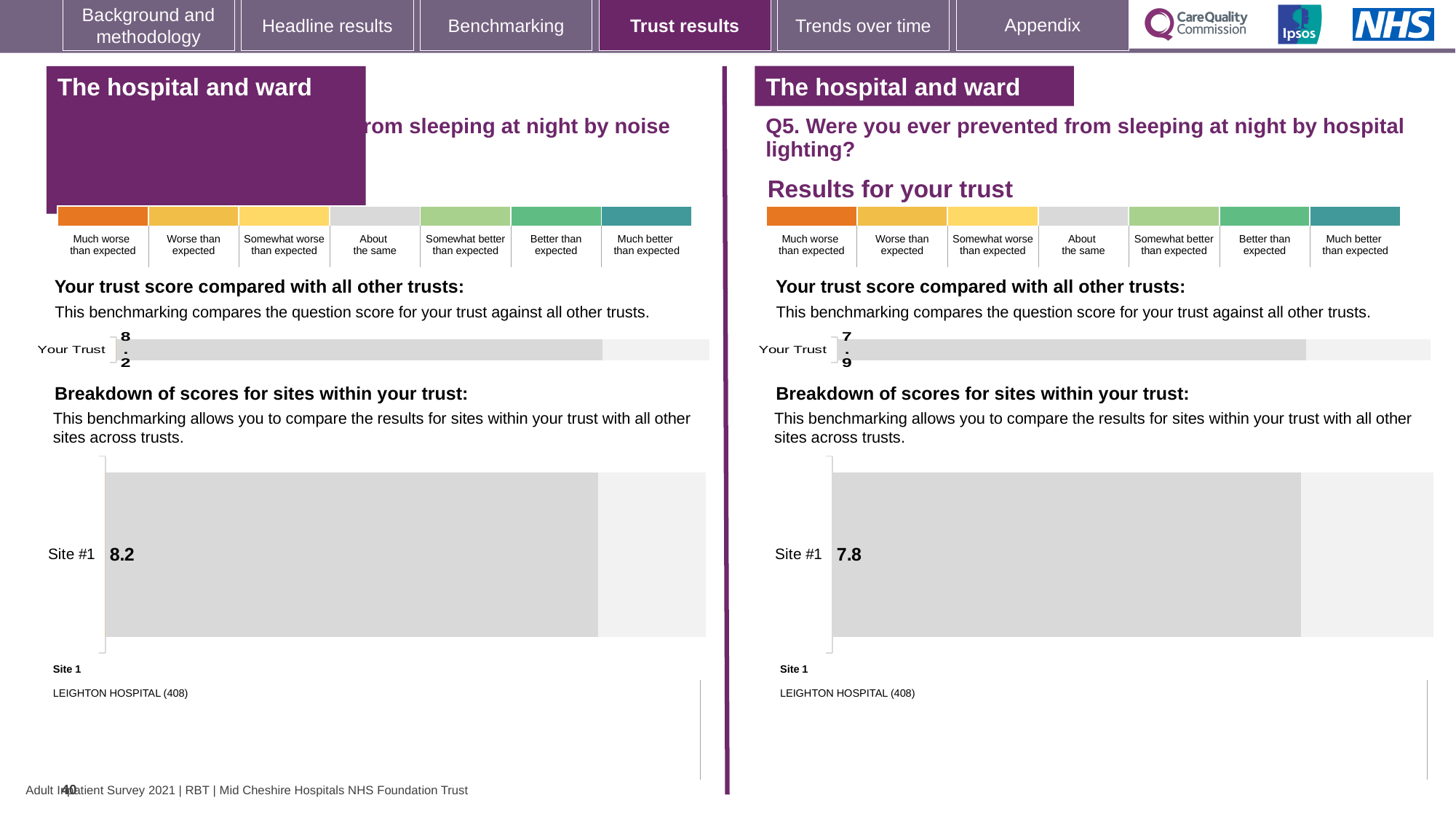
Which hospital is listed as Site 1 beneath the right-hand 'Breakdown of scores for sites within your trust' chart (Q5, hospital lighting)? LEIGHTON HOSPITAL (408) Which is larger: the Site #1 score on the left-hand breakdown chart (noise) or the Site #1 score on the right-hand breakdown chart (Q5, hospital lighting)? Left-hand (noise) Site #1, 8.2 On the left-hand 'Breakdown of scores for sites within your trust' chart (sleeping at night by noise), what is the score for Site #1? 8.2 On the left-hand 'Your trust score compared with all other trusts' chart (sleeping at night by noise), what is the value shown for Your Trust? 8.2 How many sites are plotted on the right-hand 'Breakdown of scores for sites within your trust' chart (Q5, hospital lighting)? 1 What is the difference between the Site #1 score on the left-hand breakdown chart (noise, 8.2) and the Site #1 score on the right-hand breakdown chart (Q5, hospital lighting, 7.8)? 0.4 What type of chart is the right-hand 'Breakdown of scores for sites within your trust' chart (Q5, hospital lighting)? Bar chart What is the difference between the Your Trust score on the left-hand chart (noise, 8.2) and the Your Trust score on the right-hand chart (Q5, hospital lighting, 7.9)? 0.3 How many sites are plotted on the left-hand 'Breakdown of scores for sites within your trust' chart (sleeping at night by noise)? 1 What is the question text shown above the right-hand charts? Q5. Were you ever prevented from sleeping at night by hospital lighting? On the right-hand 'Your trust score compared with all other trusts' chart (Q5, hospital lighting), what is the value shown for Your Trust? 7.9 On the right-hand 'Breakdown of scores for sites within your trust' chart (Q5, hospital lighting), what is the score for Site #1? 7.8